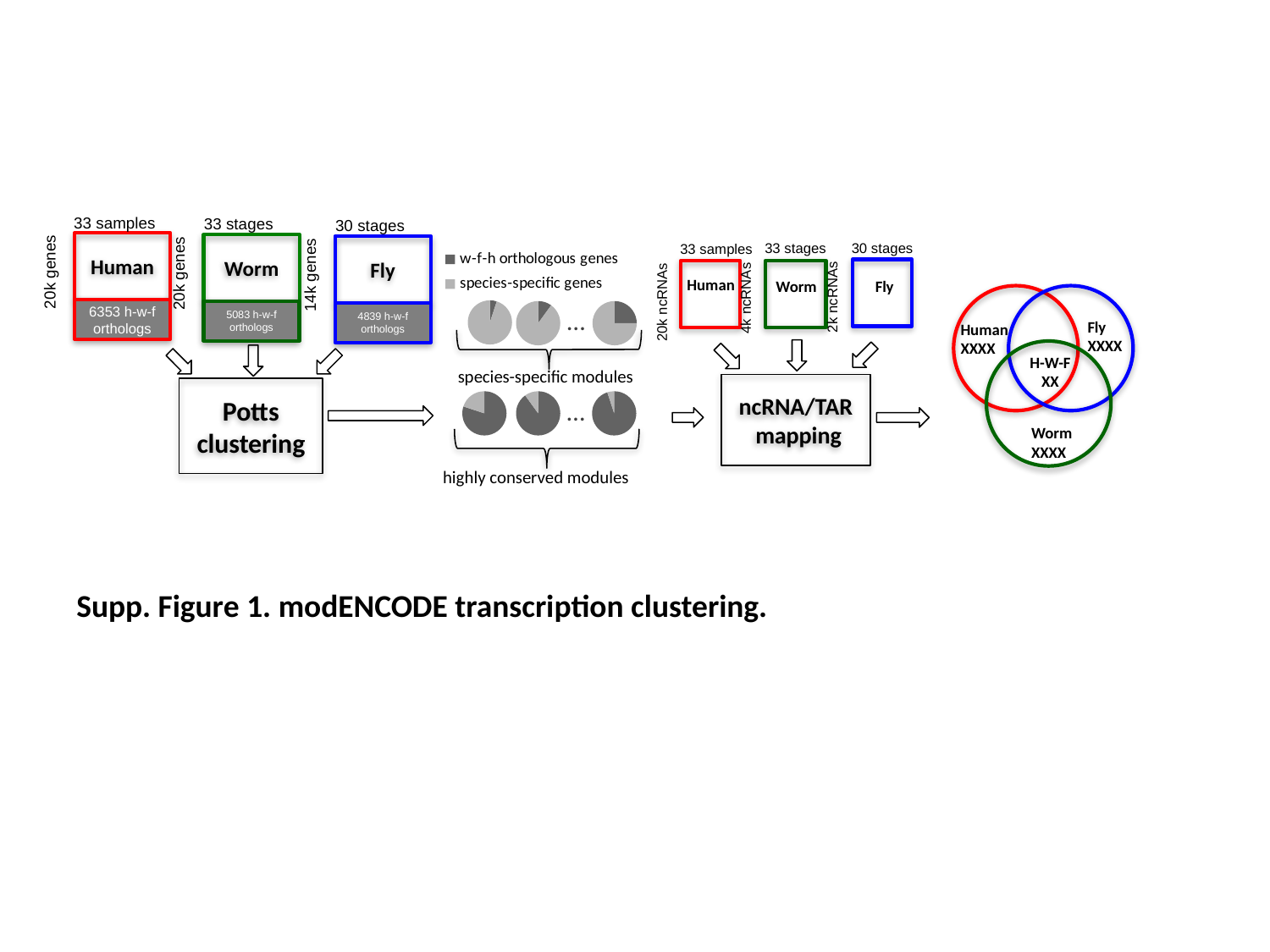
Which legend entry is shown in dark grey in the module pie charts? w-f-h orthologous genes What kind of chart is used to depict the species-specific modules and highly conserved modules? pie chart In the pie charts labelled highly conserved modules, which legend category takes the larger share: w-f-h orthologous genes or species-specific genes? w-f-h orthologous genes Which legend entry is shown in light grey in the module pie charts? species-specific genes In the pie charts labelled species-specific modules, which legend category takes the larger share: w-f-h orthologous genes or species-specific genes? species-specific genes How many entries does the legend for the module pie charts list? 2